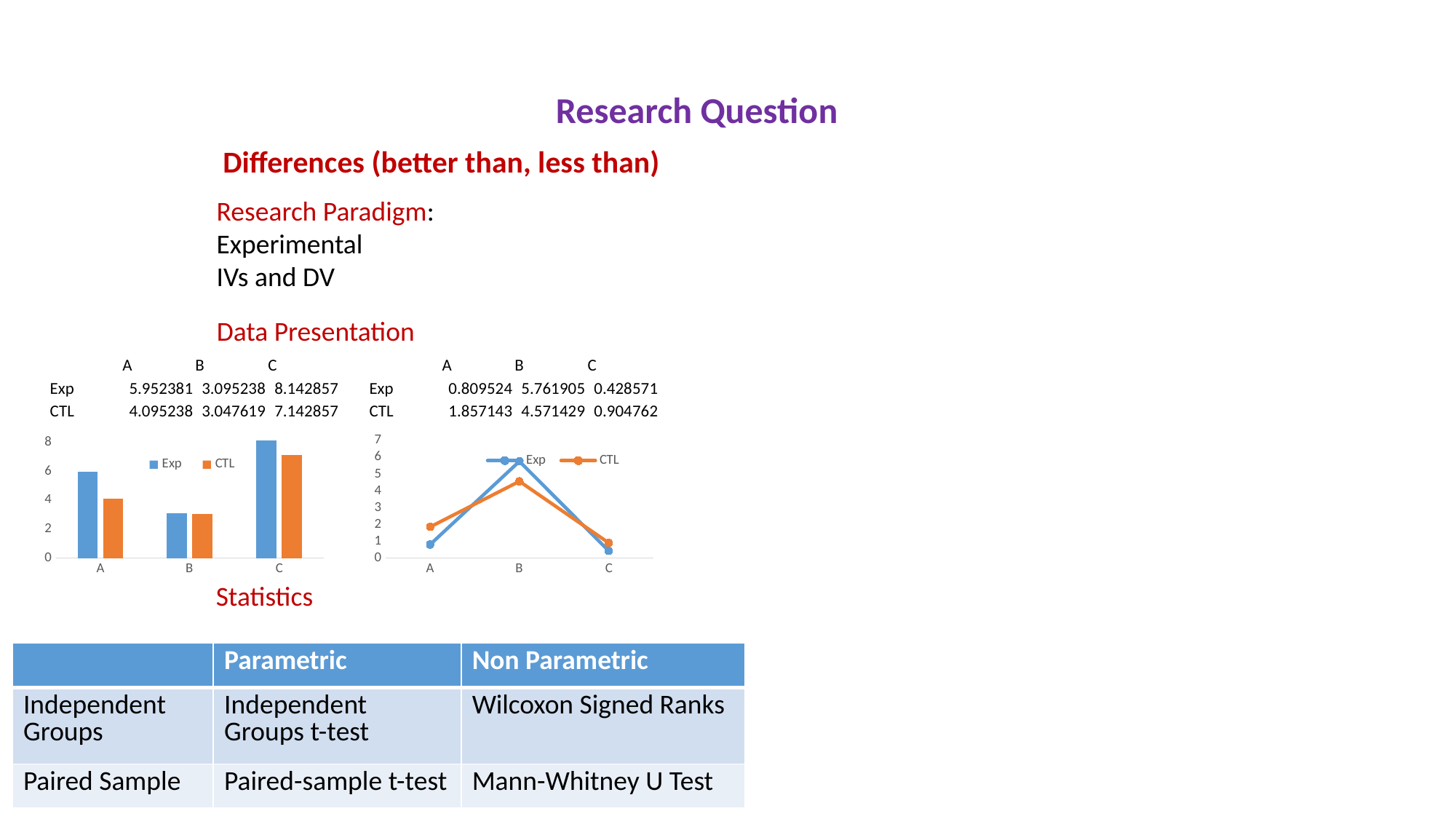
In the bar chart on the left, what colour are the CTL bars? orange In the bar chart on the left, what is the Exp value for category C? 8.142857 What kind of chart is the chart on the right of the slide? line chart In the line chart on the right, what is the difference between the Exp and CTL values for category B? 1.190476 In the line chart on the right, which category has the lowest Exp value? C In the bar chart on the left, is the CTL value for category C greater or less than 6? greater In the bar chart on the left, for category A, which is larger: Exp or CTL? Exp What kind of chart is the chart on the left of the slide? bar chart In the line chart on the right, how many categories are shown on the x axis? 3 In the line chart on the right, what is the CTL value for category B? 4.571429 In the bar chart on the left, which category has the highest Exp value? C In the bar chart on the left, how many series does the legend list? 2